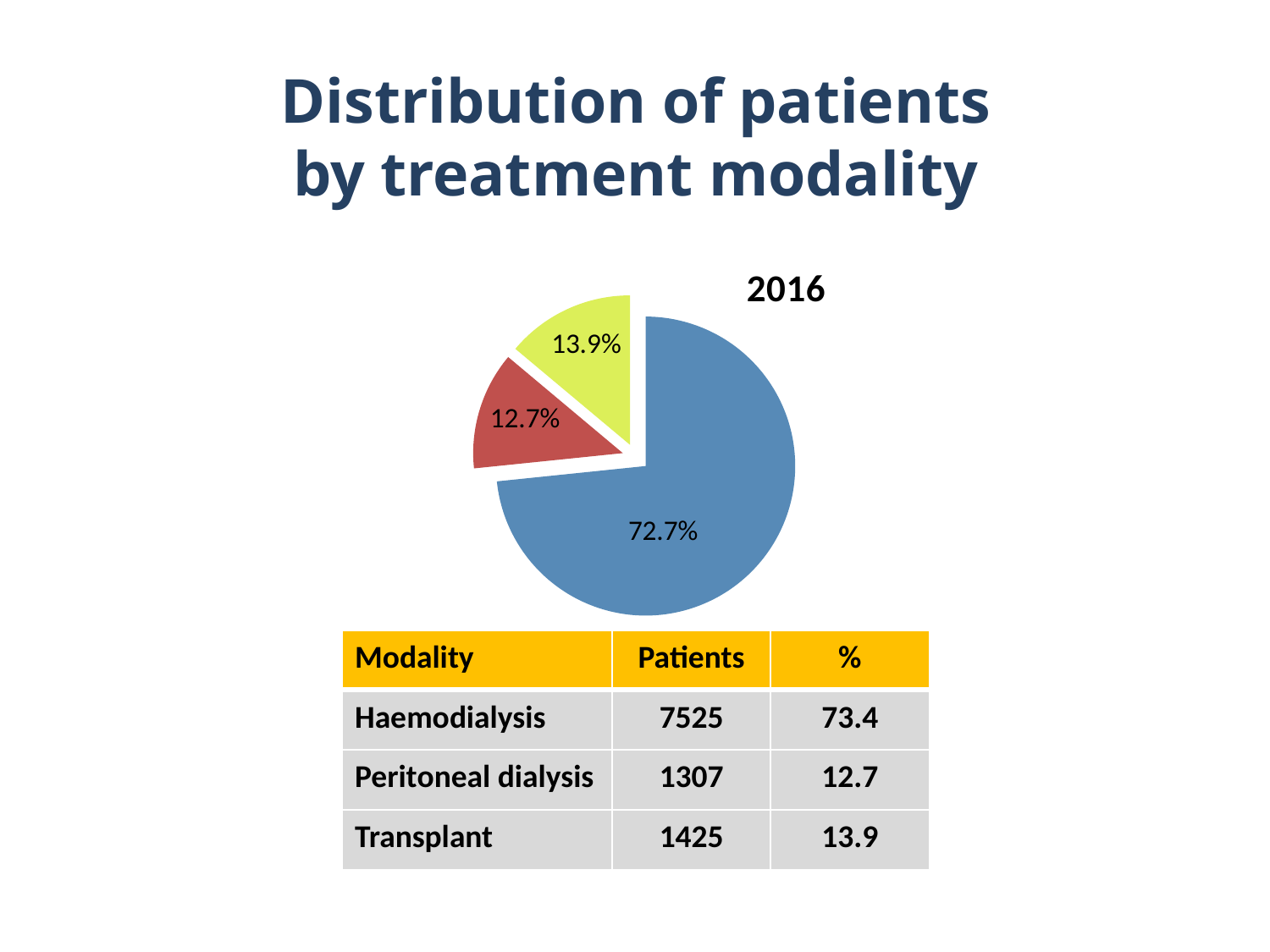
What kind of chart is shown on the slide? Pie chart What is the difference between the yellow-green slice (13.9%) and the red slice (12.7%) in the pie chart? 1.2 percentage points What is the title shown above the pie chart? 2016 Which is larger in the pie chart, the red slice or the yellow-green slice? The yellow-green slice (13.9%) What is the value of the largest slice of the pie chart? 72.7% What percentage is shown on the red slice of the pie chart? 12.7% What share of the pie chart does the blue slice represent? 72.7% How many slices does the pie chart have? 3 What percentage is shown on the yellow-green slice of the pie chart? 13.9% What is the value of the smallest slice of the pie chart? 12.7% What colour is the largest slice of the pie chart? Blue What percentage is shown on the blue slice of the pie chart? 72.7%